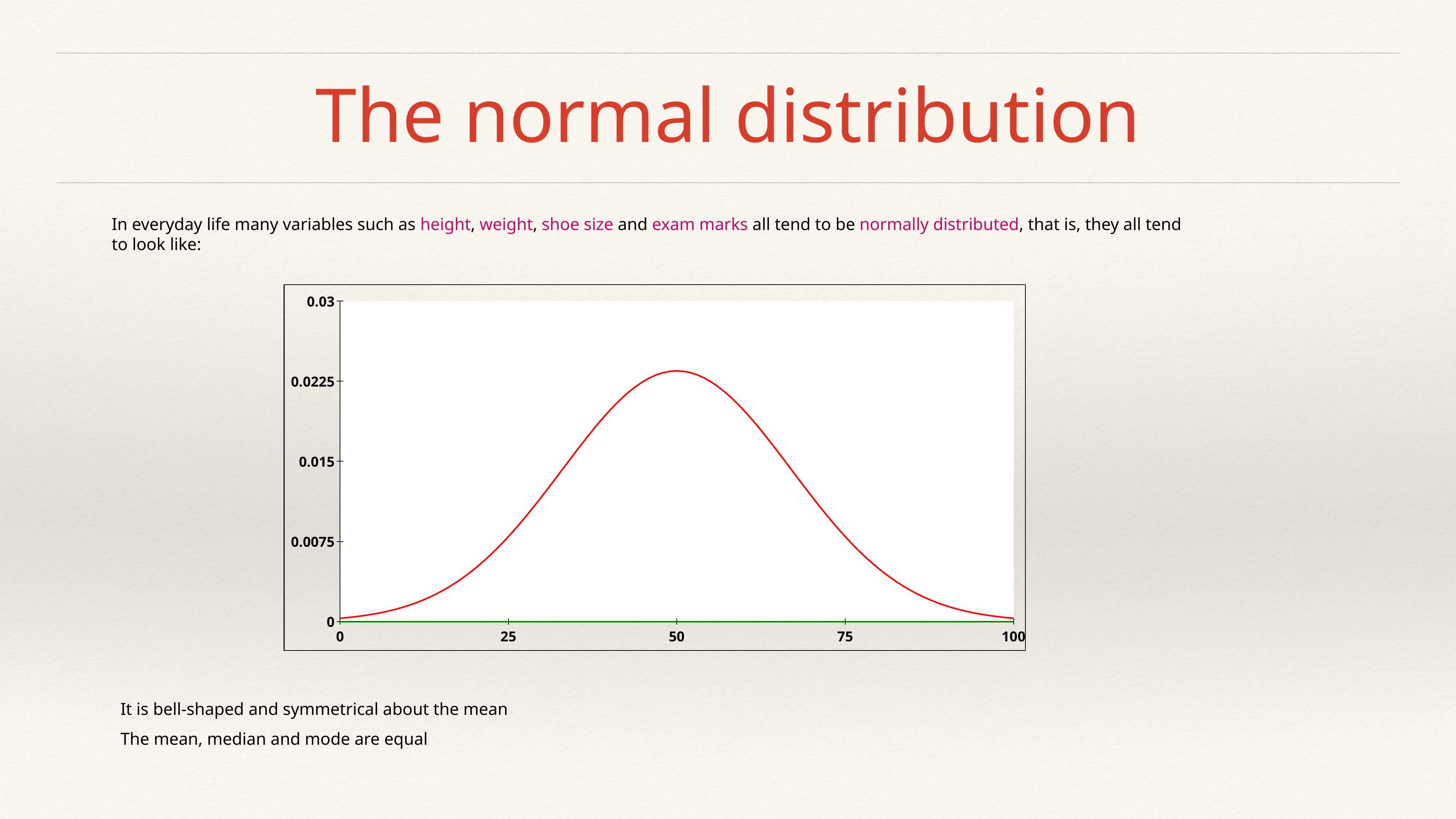
Does the curve rise or fall as x goes from 0 to 50? rises What kind of chart is shown on the slide? line chart At which x-axis value does the red curve reach its highest point? 50 What colour is the curve plotted on the chart? red How many labelled tick marks are on the x axis? 5 Is the value of the curve at x = 0 greater or less than 0.0075? less Is the value of the curve at x = 75 greater or less than 0.015? less Is the value of the curve at x = 50 greater or less than 0.015? greater Does the curve rise or fall as x goes from 50 to 100? falls Which is larger, the value of the curve at x = 50 or at x = 25? x = 50 What is the highest value labelled on the y axis? 0.03